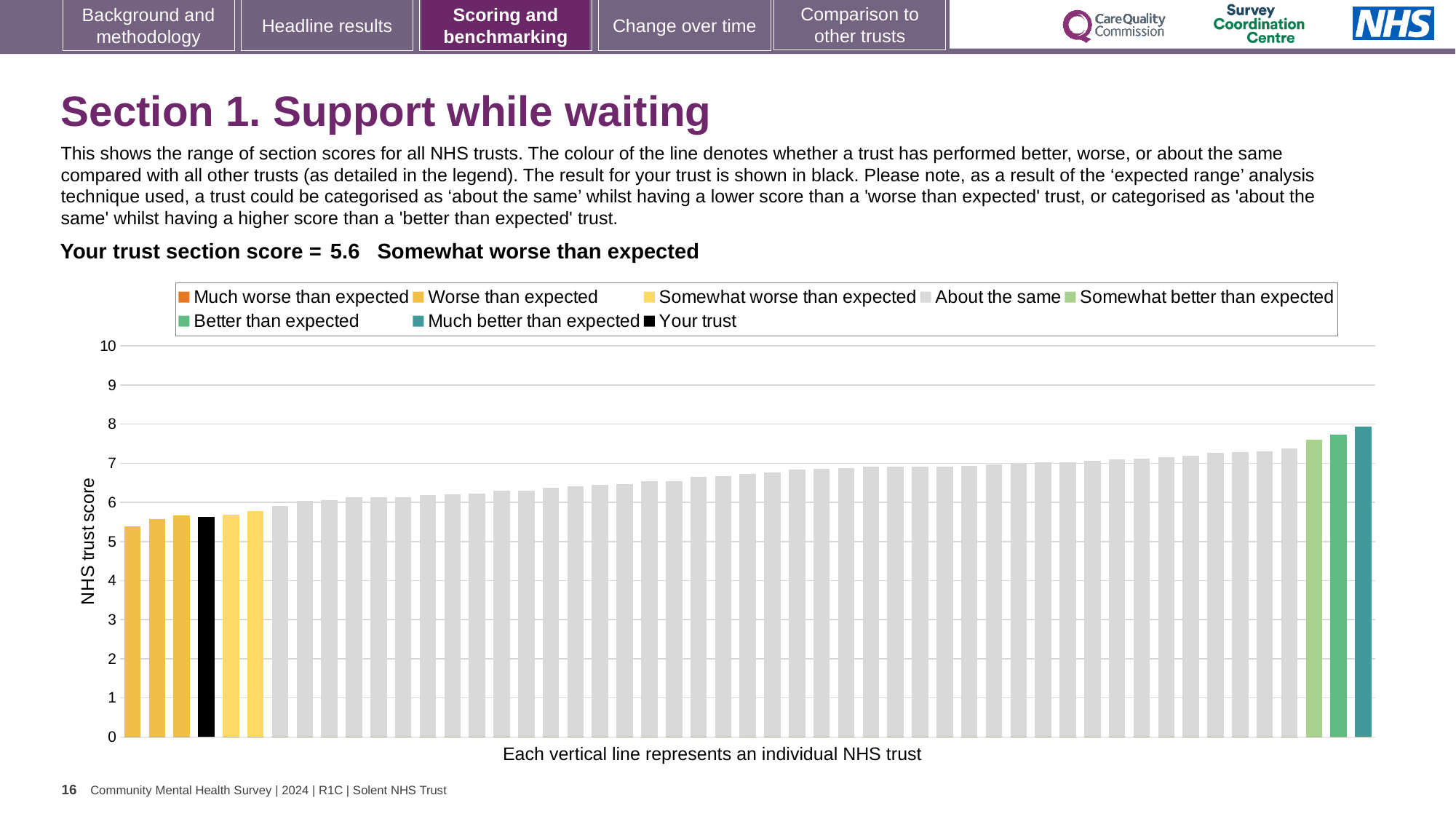
What is the trust's section score for Support while waiting? 5.6 Is the value of the black 'Your trust' bar greater or less than 6? less How many bars are to the left of the black 'Your trust' bar? 3 Is the value of the black 'Your trust' bar greater or less than 5? greater Is the value of the leftmost bar greater or less than 6? less What colour is the bar representing your trust? black What kind of chart is shown on the slide? bar chart How many entries does the chart legend list? 8 What is the title of the vertical axis? NHS trust score Do the bar values rise or fall from left to right along the x axis? rise Which legend category does the tallest bar belong to? Much better than expected